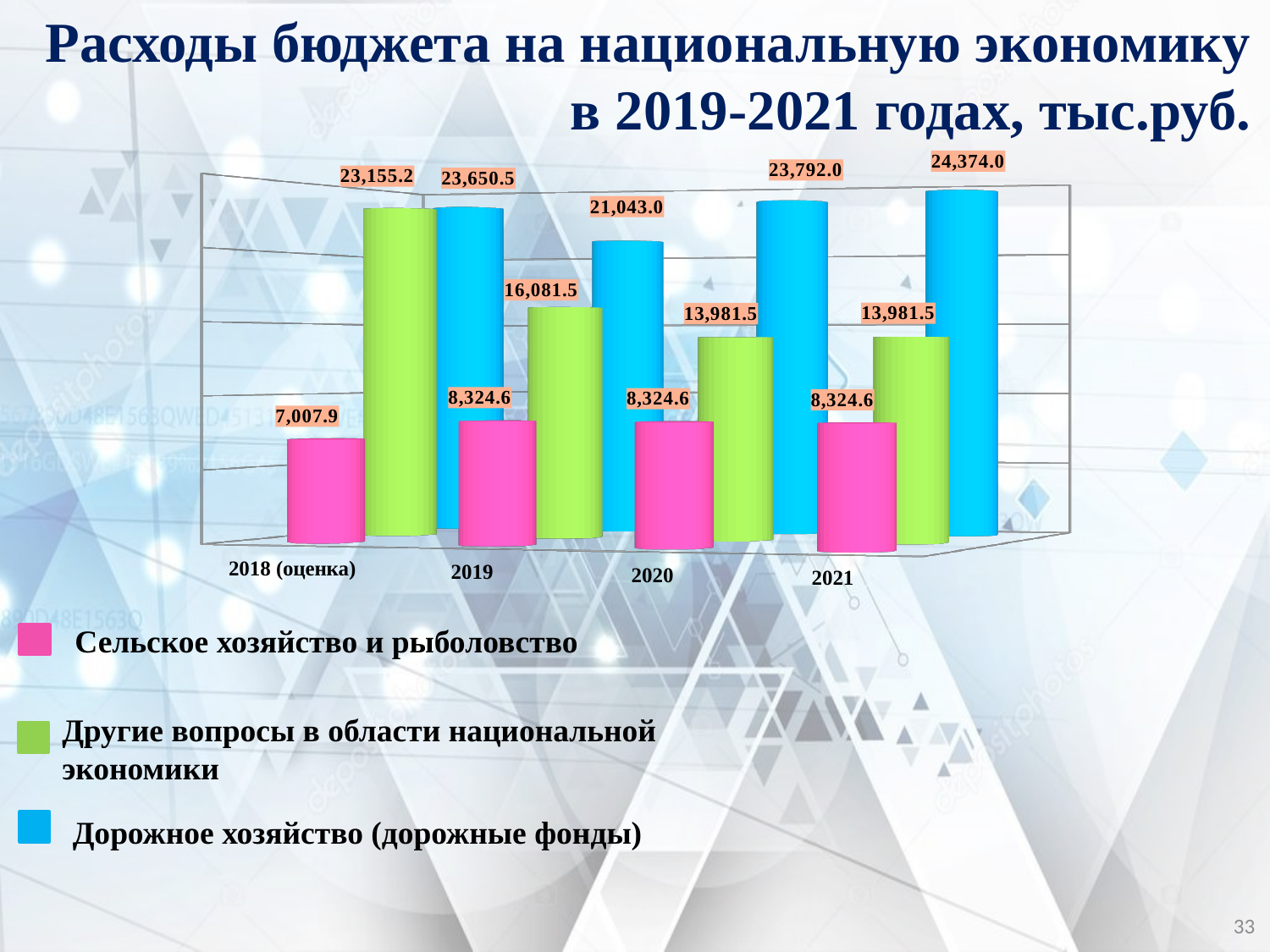
What kind of chart is shown on the slide? Bar chart What is the difference between the Дорожное хозяйство (дорожные фонды) values in 2021 and 2020? 582.0 What is the value for Дорожное хозяйство (дорожные фонды) in 2021? 24,374.0 What is the value for Другие вопросы в области национальной экономики in 2019? 16,081.5 In which year is the value for Дорожное хозяйство (дорожные фонды) lowest? 2019 What is the difference between the Другие вопросы в области национальной экономики values in 2018 (оценка) and 2019? 7,073.7 In which year is the value for Другие вопросы в области национальной экономики highest? 2018 (оценка) How many years are shown on the x axis of the chart? 4 What is the value for Сельское хозяйство и рыболовство in 2018 (оценка)? 7,007.9 Which is larger in 2018 (оценка): Другие вопросы в области национальной экономики or Дорожное хозяйство (дорожные фонды)? Дорожное хозяйство (дорожные фонды) How many series does the legend list? 3 What is the value for Дорожное хозяйство (дорожные фонды) in 2020? 23,792.0